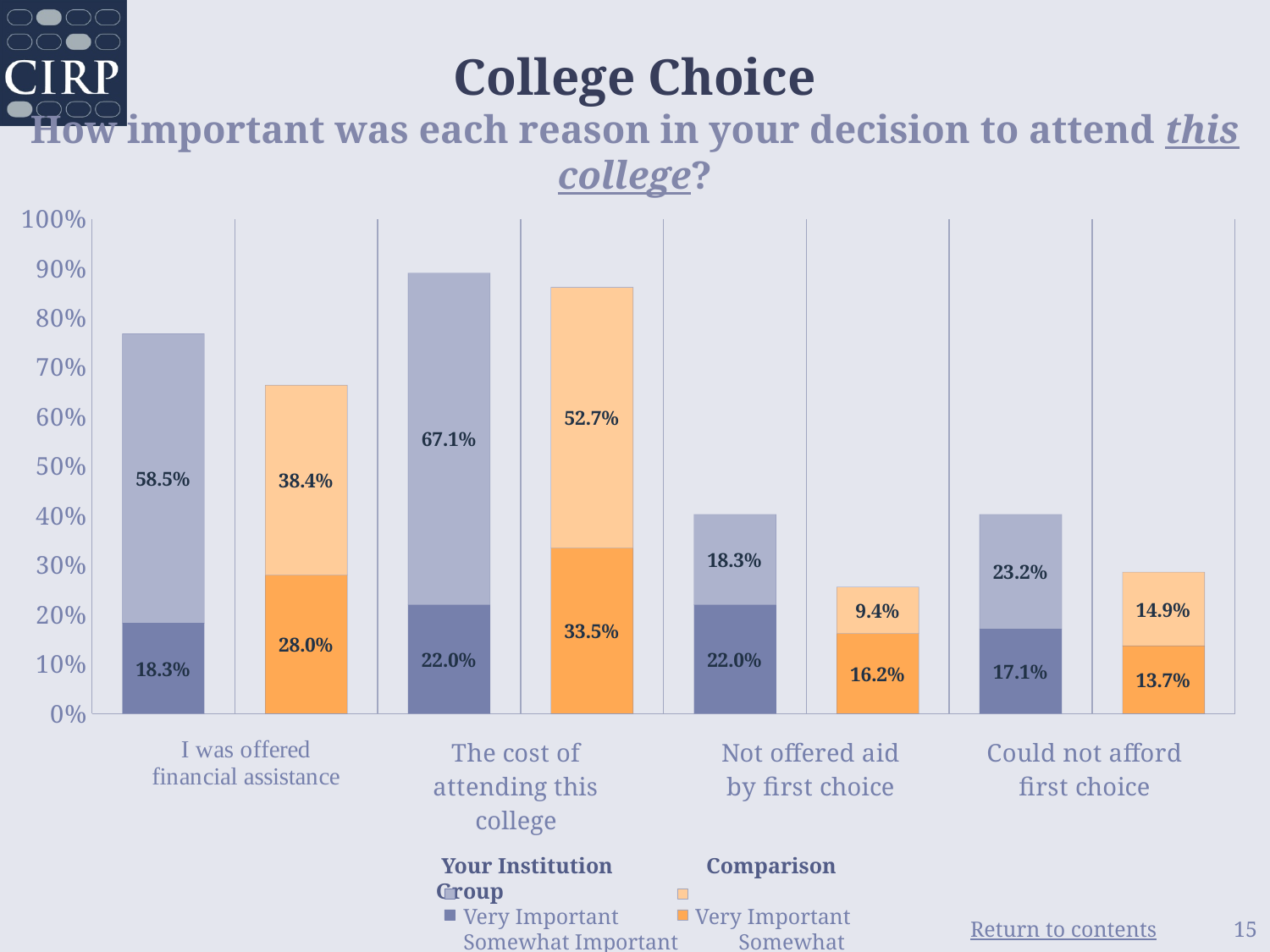
What is the Very Important percentage for the Comparison Group on "Could not afford first choice"? 14.9% What is the total height of the Comparison Group stacked bar for "Not offered aid by first choice"? 25.6% What percentage of the Comparison Group rated "The cost of attending this college" as Somewhat Important? 33.5% For "Could not afford first choice", which is larger: the Your Institution Very Important value or the Comparison Group Very Important value? Your Institution What is the total height of the Your Institution stacked bar for "The cost of attending this college"? 89.1% What is the Somewhat Important percentage for Your Institution on "Not offered aid by first choice"? 22.0% What type of chart is shown on the slide? Stacked bar chart What percentage of Your Institution respondents rated "I was offered financial assistance" as Very Important? 58.5% What is the difference between the Comparison Group's Very Important value and Your Institution's Very Important value for "I was offered financial assistance"? 20.1% Which reason has the lowest Somewhat Important percentage for the Comparison Group? Could not afford first choice How many reasons (categories) are shown on the x axis? 4